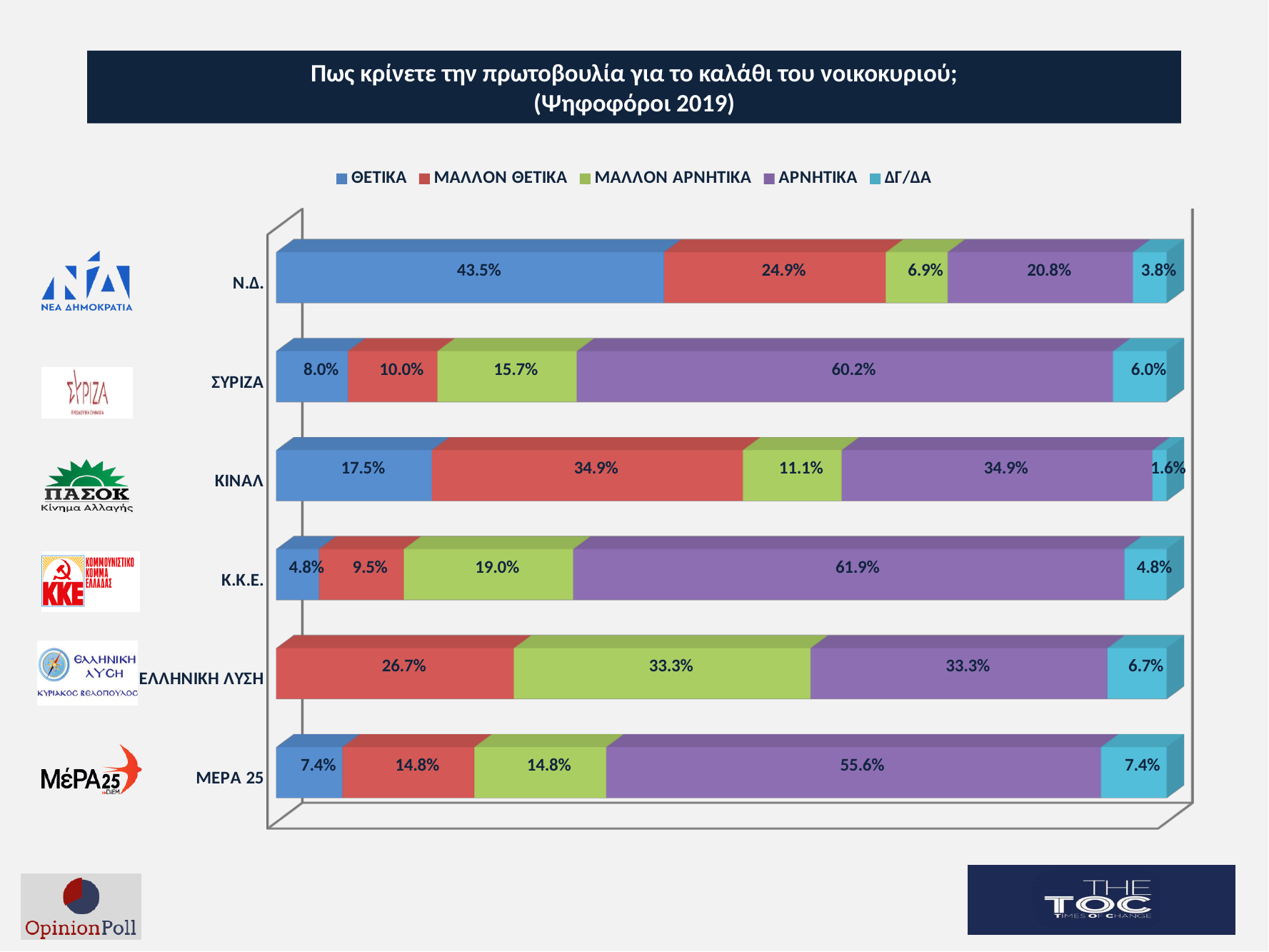
Which is larger: the ΜΑΛΛΟΝ ΘΕΤΙΚΑ value for ΚΙΝΑΛ or the ΜΑΛΛΟΝ ΘΕΤΙΚΑ value for ΕΛΛΗΝΙΚΗ ΛΥΣΗ? ΚΙΝΑΛ Which party has the highest ΑΡΝΗΤΙΚΑ value? Κ.Κ.Ε. What is the difference between the ΘΕΤΙΚΑ value for Ν.Δ. and the ΘΕΤΙΚΑ value for ΚΙΝΑΛ? 26.0% Which party has the lowest ΘΕΤΙΚΑ value among those with a ΘΕΤΙΚΑ segment? Κ.Κ.Ε. What is the combined ΘΕΤΙΚΑ and ΜΑΛΛΟΝ ΘΕΤΙΚΑ value for ΜΕΡΑ 25? 22.2% What is the ΑΡΝΗΤΙΚΑ value for ΣΥΡΙΖΑ? 60.2% What kind of chart is shown on the slide? Stacked bar chart How many series does the legend list? 5 What is the ΜΑΛΛΟΝ ΑΡΝΗΤΙΚΑ value for Κ.Κ.Ε.? 19.0% What is the ΔΓ/ΔΑ value for ΚΙΝΑΛ? 1.6% What is the ΘΕΤΙΚΑ value for Ν.Δ.? 43.5% How many parties are shown on the chart? 6